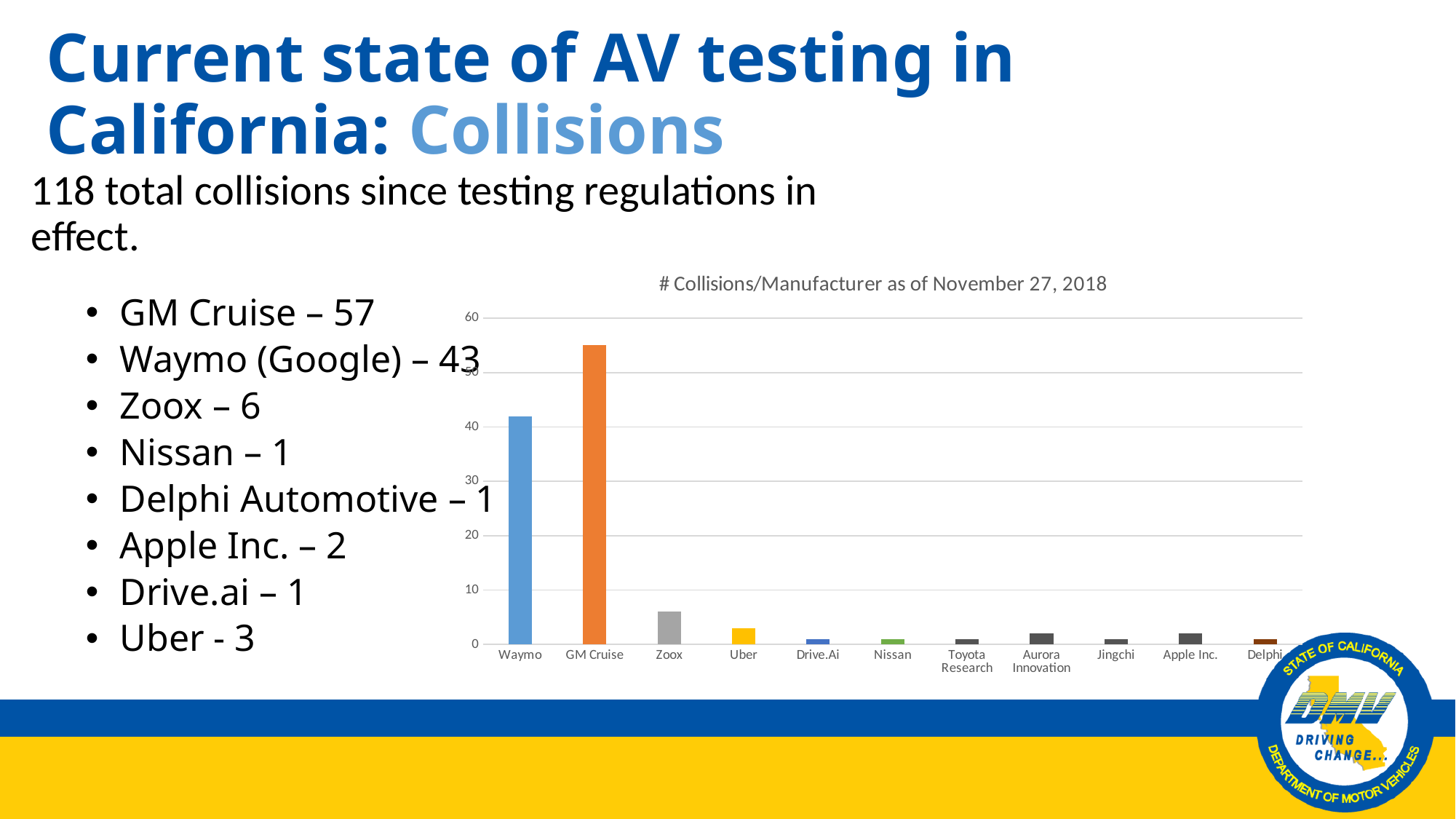
Is the value for Uber greater or less than 10? less Which has more collisions in the chart, Zoox or Uber? Zoox Is the value for Waymo greater or less than 50? less What is the title of the chart? # Collisions/Manufacturer as of November 27, 2018 What colour is the bar for GM Cruise? orange Which manufacturer has the highest number of collisions in the chart? GM Cruise Is the value for GM Cruise greater or less than 50? greater Which has more collisions in the chart, Waymo or GM Cruise? GM Cruise How many manufacturers are shown on the x axis of the chart? 11 What kind of chart is shown on the slide? bar chart Which has more collisions in the chart, Waymo or Zoox? Waymo